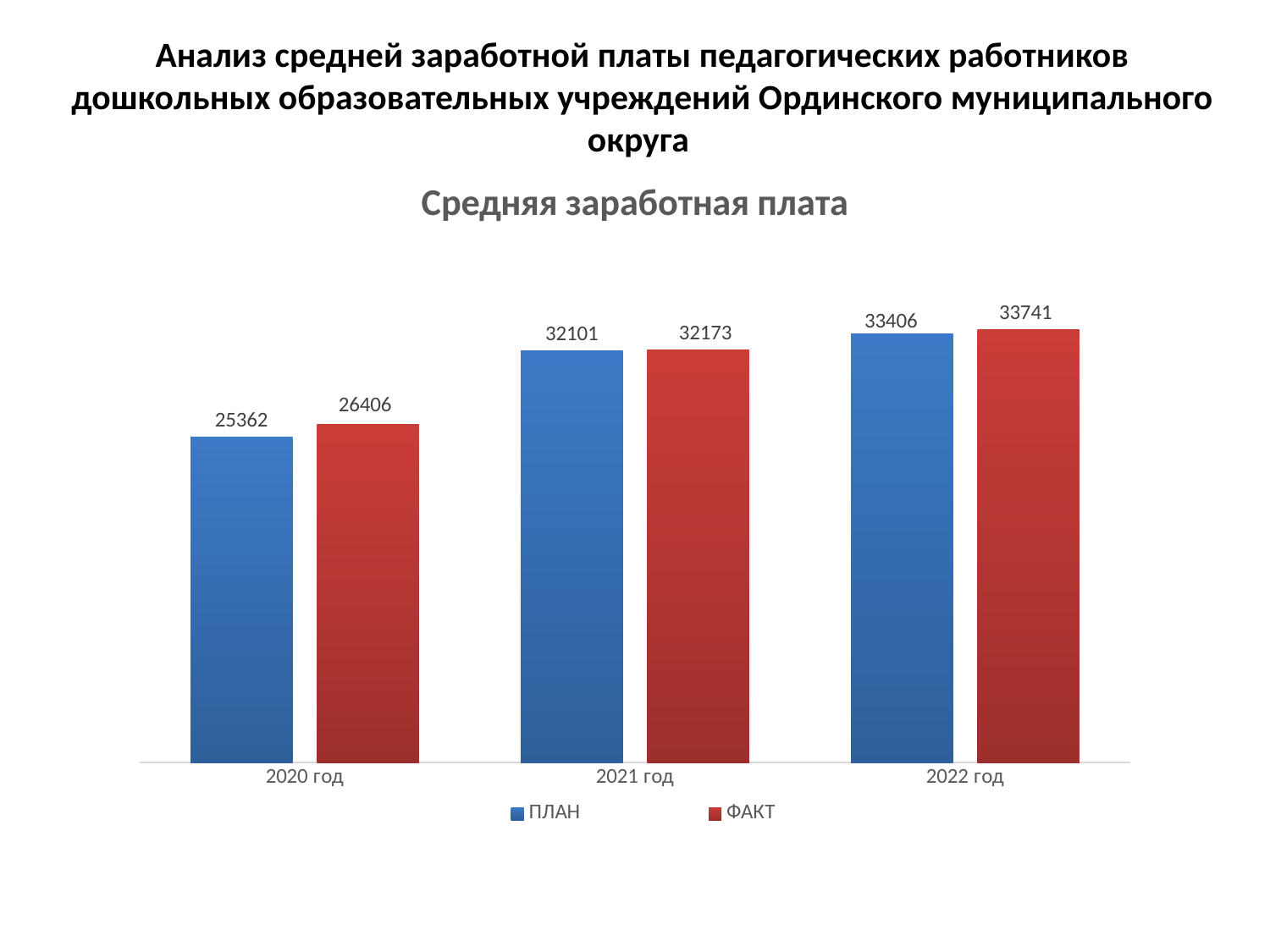
How many years are shown on the x axis? 3 How many series does the legend list? 2 Which year has the highest ФАКТ value? 2022 год Which year has the lowest ПЛАН value? 2020 год What is the difference between the ПЛАН values for 2022 год and 2021 год? 1305 What is the ФАКТ value for 2021 год? 32173 What is the ПЛАН value for 2020 год? 25362 What is the ФАКТ value for 2022 год? 33741 What kind of chart is shown on the slide? Bar chart Do the ПЛАН values rise or fall from 2020 год to 2022 год? Rise Which is larger: the ПЛАН value for 2021 год or the ФАКТ value for 2020 год? ПЛАН value for 2021 год What is the difference between the ФАКТ and ПЛАН values for 2020 год? 1044